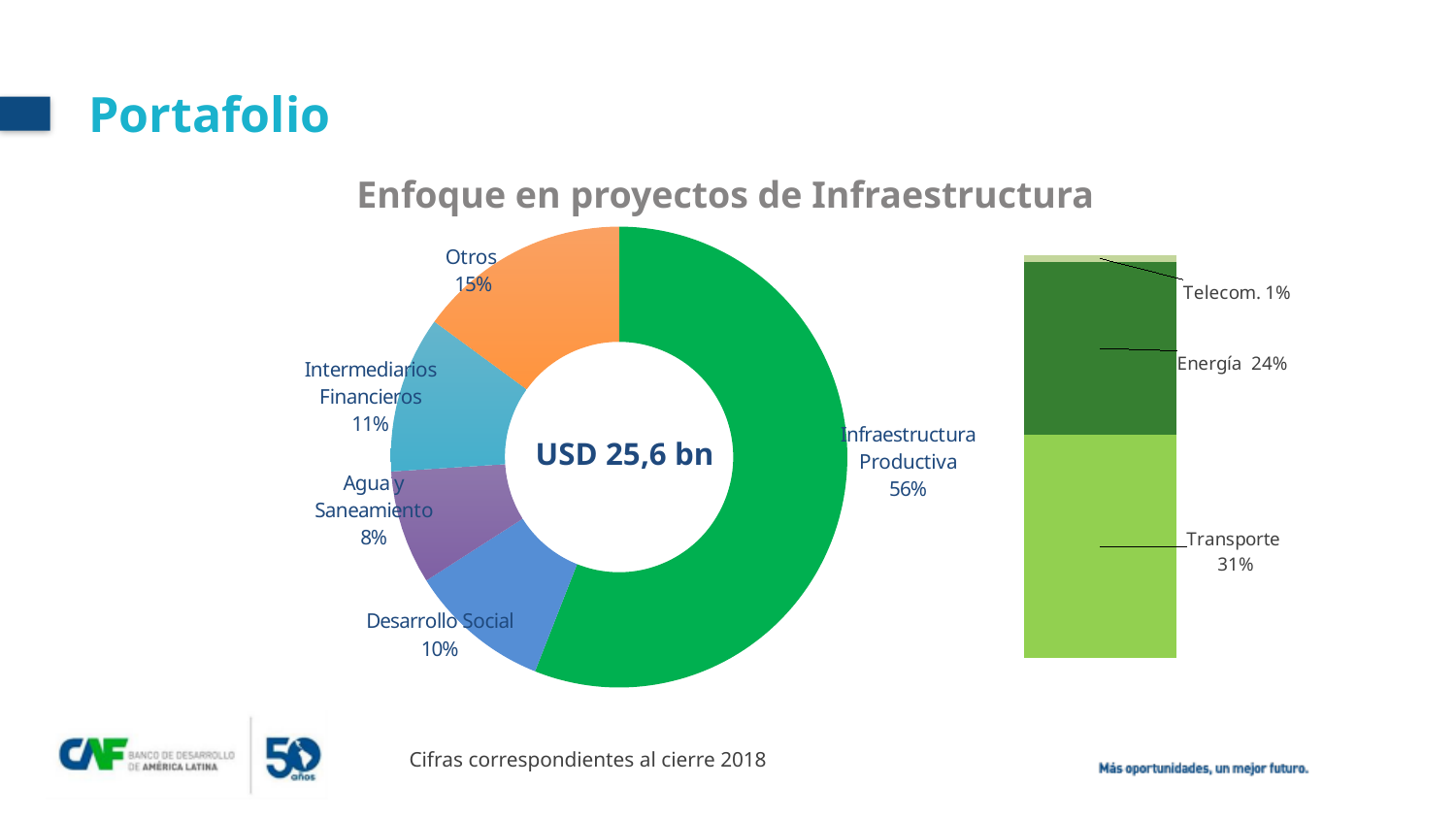
In the donut chart on the left, how many categories are shown? 5 In the stacked bar on the right, what share is Transporte? 31% In the donut chart on the left, which is larger: Otros or Intermediarios Financieros? Otros In the donut chart on the left, what share is Intermediarios Financieros? 11% In the stacked bar on the right, which segment is the smallest? Telecom. In the donut chart on the left, what is the difference between the shares of Otros and Desarrollo Social? 5% In the donut chart on the left, what share of the portfolio is Infraestructura Productiva? 56% In the donut chart on the left, what share is Agua y Saneamiento? 8% In the stacked bar on the right, what share is Energía? 24% In the donut chart on the left, which category has the largest share? Infraestructura Productiva What total value is printed in the centre of the donut chart? USD 25,6 bn In the donut chart on the left, which category has the smallest share? Agua y Saneamiento